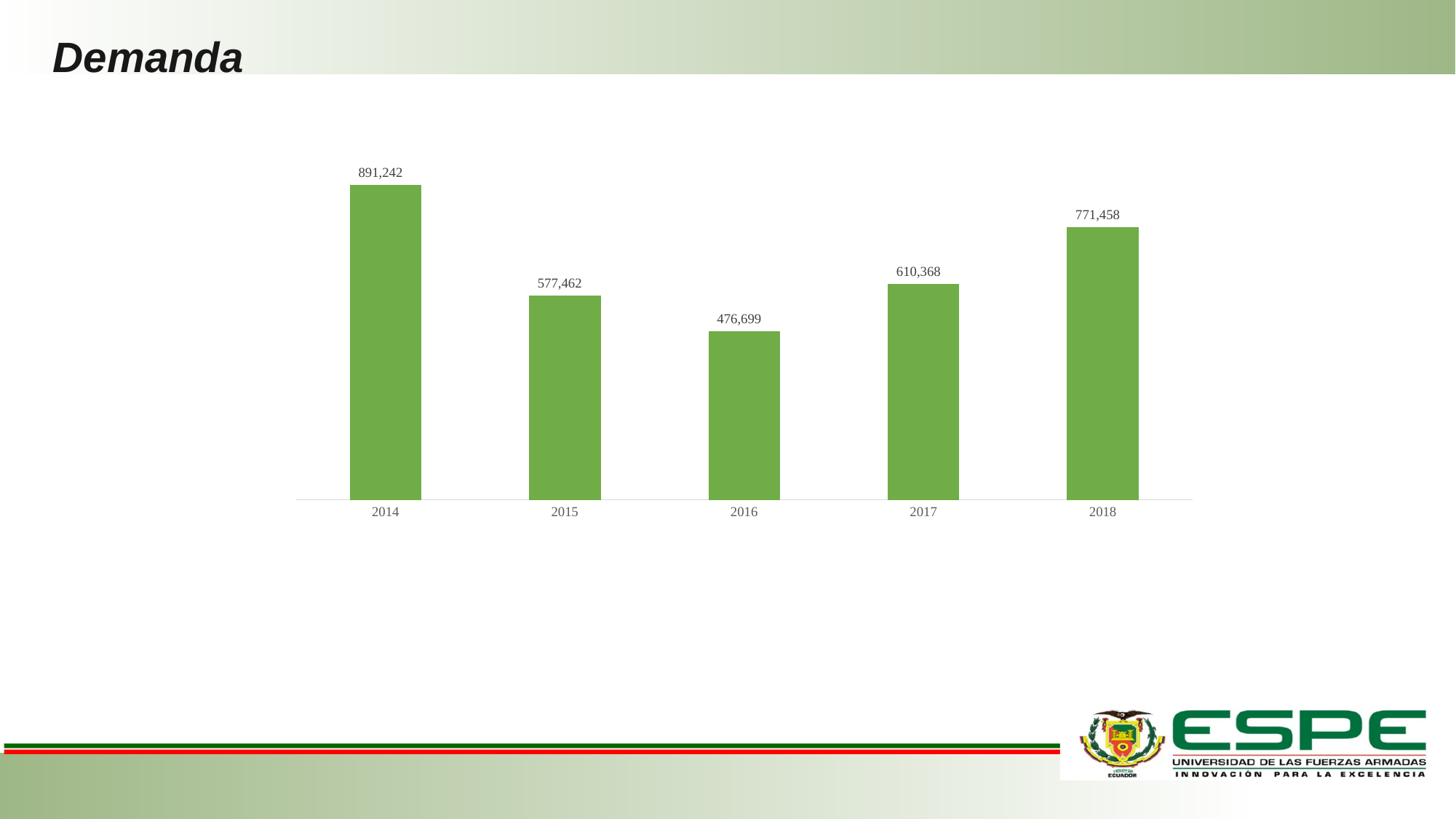
How many years are shown on the x axis? 5 Which year has the lowest value? 2016 What is the value for 2017? 610,368 Do the values rise or fall from 2016 to 2018? Rise What is the difference between the values for 2014 and 2016? 414,543 What is the value for 2016? 476,699 What kind of chart is shown on the slide? Bar chart What is the value for 2018? 771,458 What is the value for 2014? 891,242 Which is larger, the value for 2015 or the value for 2017? 2017 What is the difference between the values for 2018 and 2017? 161,090 Which year has the highest value? 2014